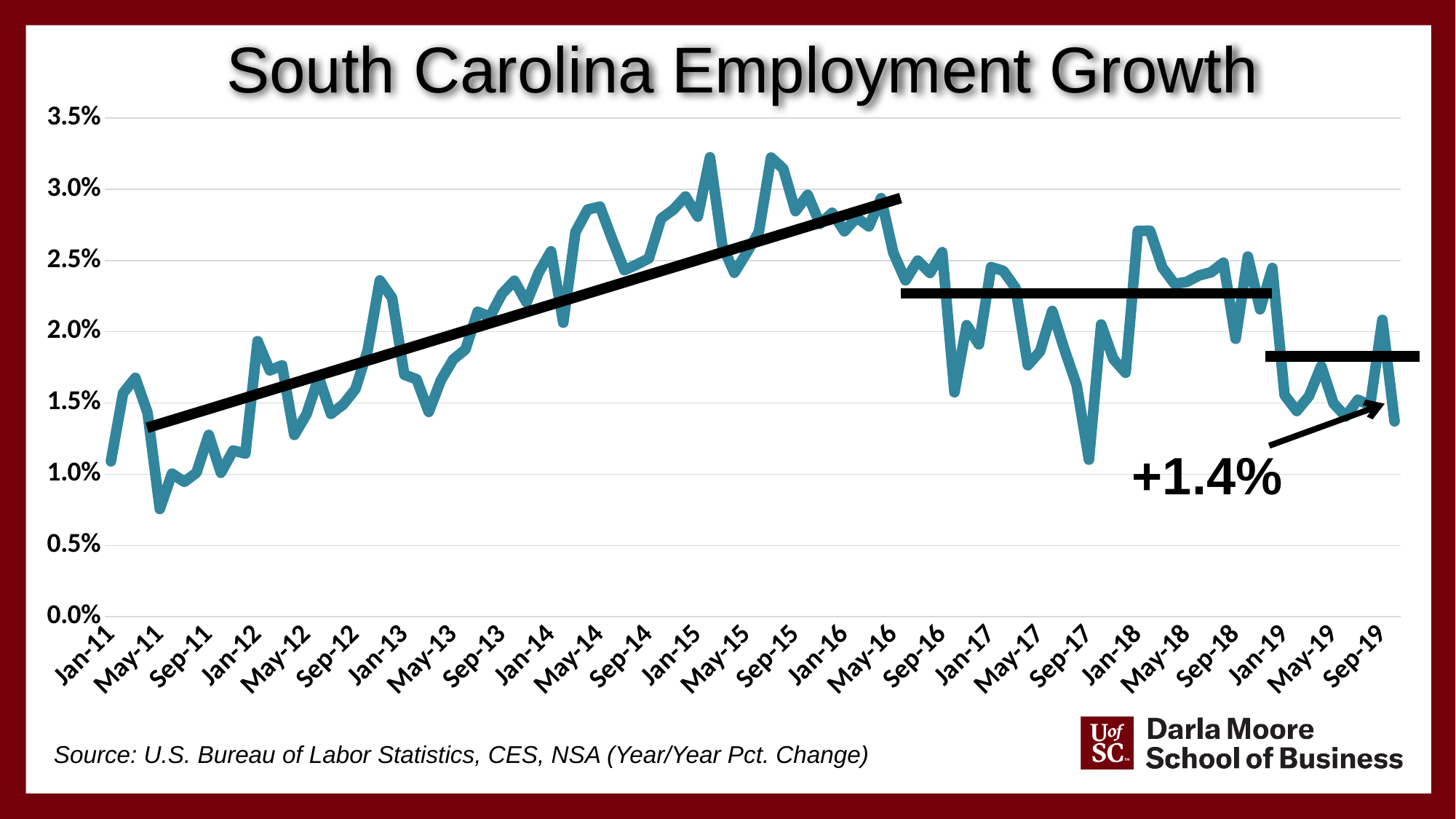
What is the title of the chart? South Carolina Employment Growth Does the black trend line drawn from Jan-11 to May-16 rise or fall? rise What value is annotated for the most recent data point (Sep-19) on the chart? +1.4% Is the employment growth value for Sep-17 greater or less than 1.5%? less Overall, do the employment growth values rise or fall from May-16 to Sep-19? fall Is the employment growth value for Jan-11 greater or less than 1.5%? less How many black trend lines are drawn over the data series? 3 Is the employment growth value for Jan-18 greater or less than 2.5%? greater What kind of chart is shown on the slide? line chart